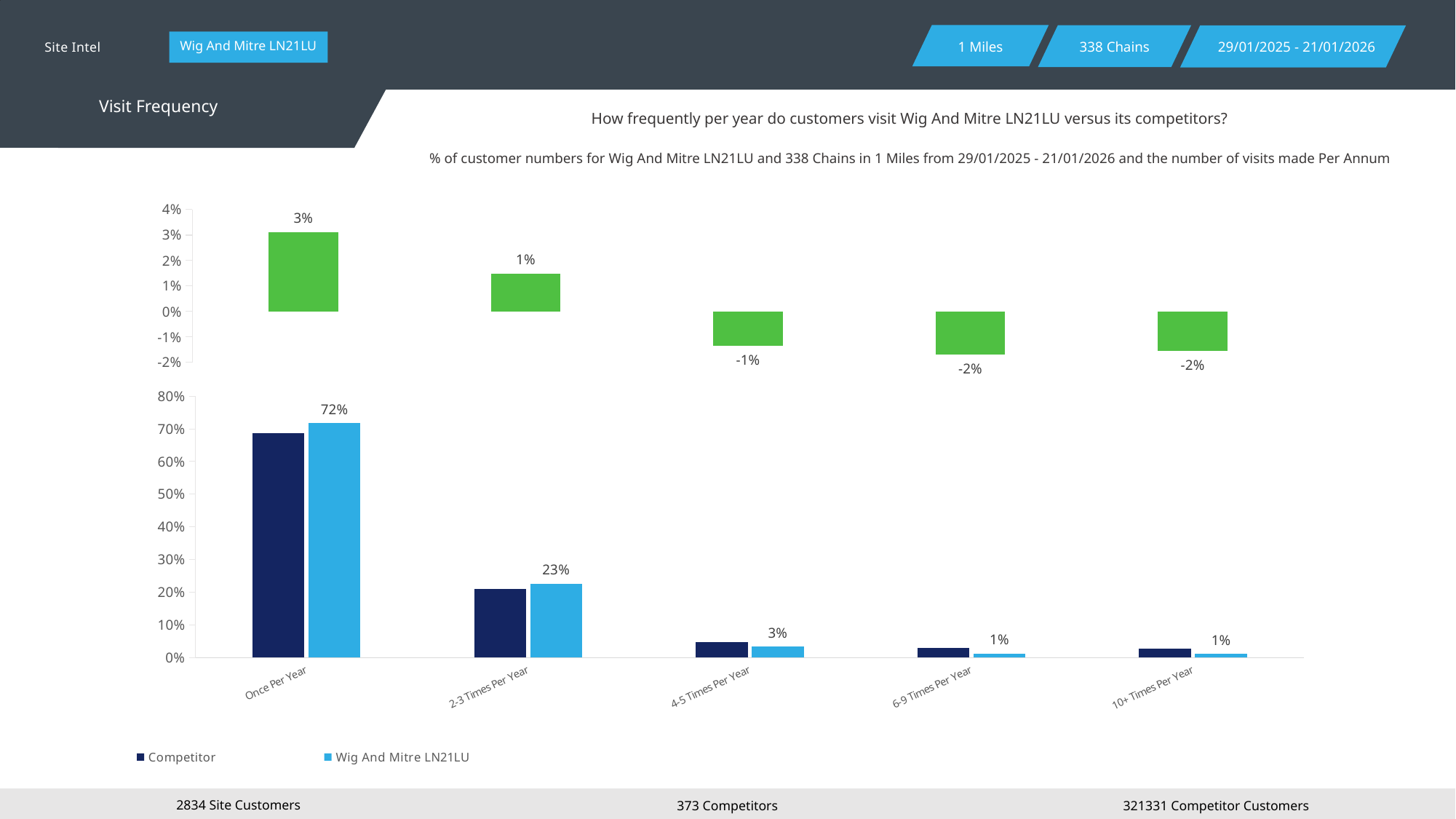
In the bottom chart, what is the value for Wig And Mitre LN21LU in the 2-3 Times Per Year category? 23% How many categories are shown on the x axis of the bottom chart? 5 In the top chart, what is the value of the rightmost green bar? -2% In the bottom chart, what is the difference between the Wig And Mitre LN21LU values for Once Per Year and 2-3 Times Per Year? 49% In the bottom chart, is the Competitor value for Once Per Year greater or less than 60%? greater How many series does the legend of the bottom chart list? 2 In the bottom chart, what is the value for Wig And Mitre LN21LU in the Once Per Year category? 72% In the bottom chart, which category has the highest value for Wig And Mitre LN21LU? Once Per Year In the bottom chart, do the Wig And Mitre LN21LU values rise or fall from left to right along the x axis? fall In the bottom chart, for the Once Per Year category, which series has the larger value: Competitor or Wig And Mitre LN21LU? Wig And Mitre LN21LU In the bottom chart, what is the value for Wig And Mitre LN21LU in the 4-5 Times Per Year category? 3% In the top chart, what is the value of the leftmost green bar? 3%